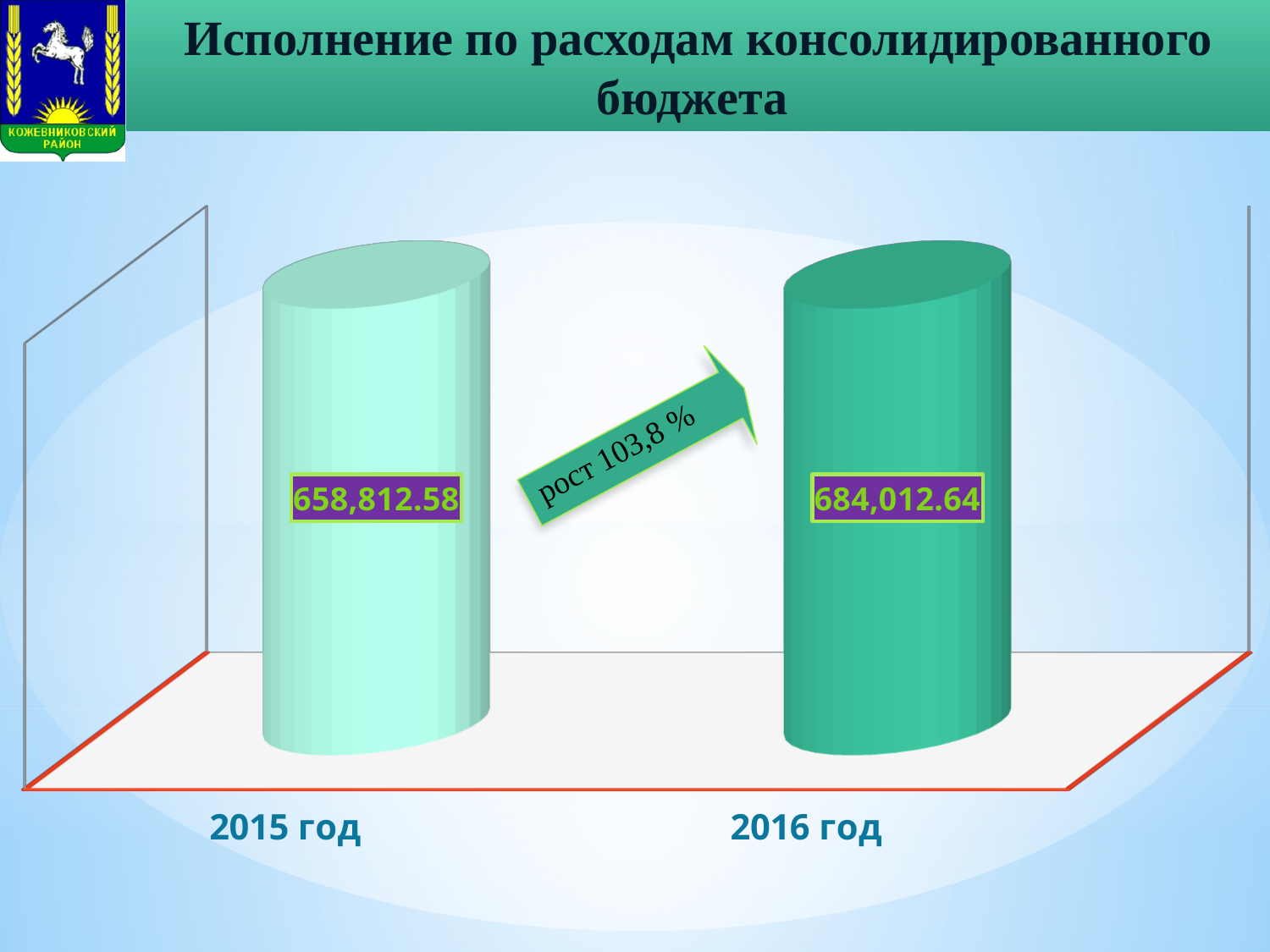
How many categories are plotted in the chart? 2 What is the title of the slide containing the chart? Исполнение по расходам консолидированного бюджета Do the values rise or fall from 2015 год to 2016 год? rise What is the value shown for 2016 год? 684,012.64 What growth percentage is written on the arrow between the two bars? 103,8 % Which year has the higher value? 2016 год Is the value for 2016 год larger or smaller than the value for 2015 год? larger What kind of chart is shown on the slide? bar chart What is the value shown for 2015 год? 658,812.58 Which year has the lower value? 2015 год What is the difference between the 2016 год and 2015 год values? 25,200.06